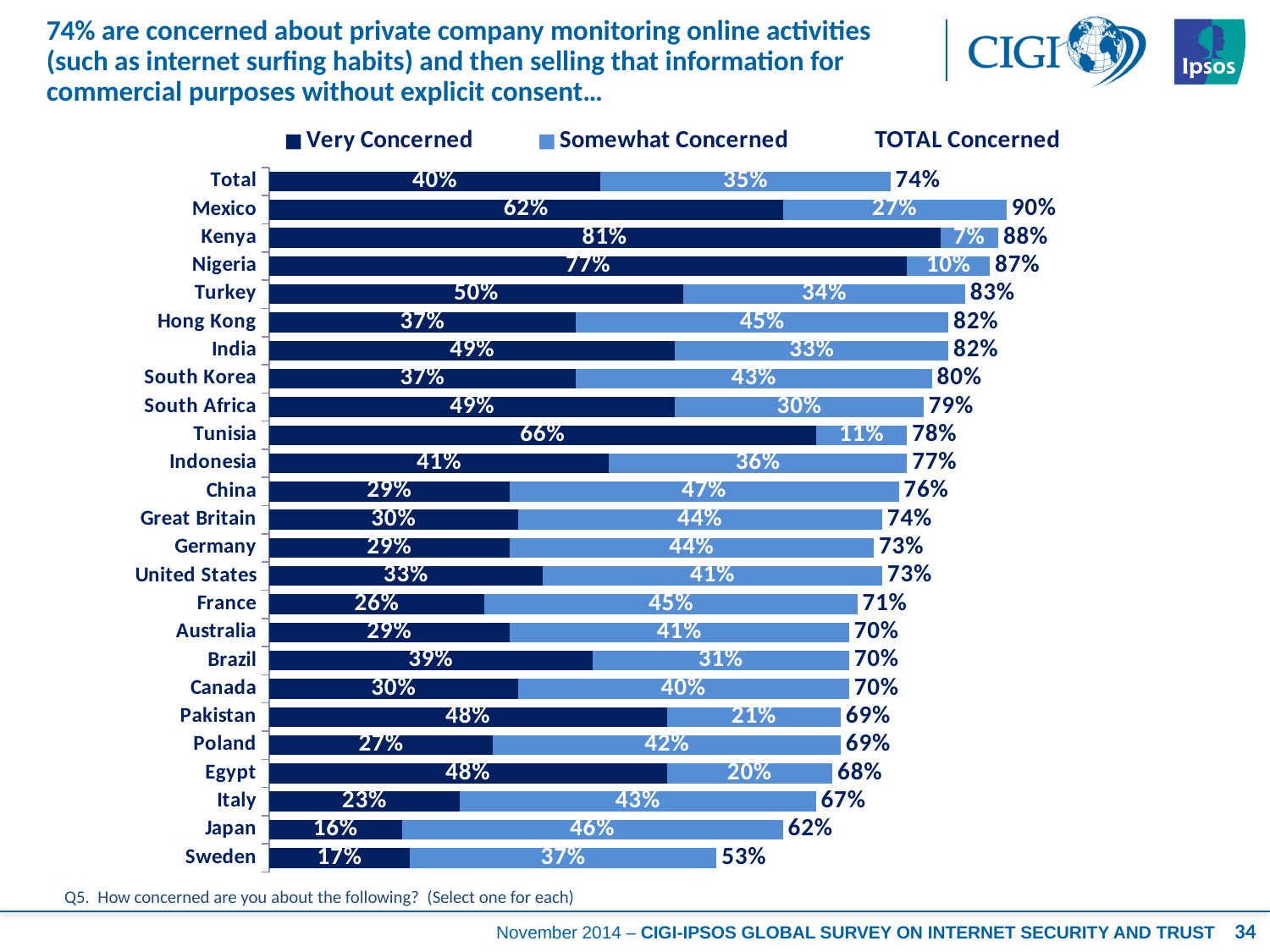
Which has a larger Somewhat Concerned value, China or Hong Kong? China What percentage of respondents in Kenya are Very Concerned? 81% What is the Somewhat Concerned value for Japan? 46% What kind of chart is shown on the slide? Stacked bar chart What is the TOTAL Concerned value for Mexico? 90% How many percentage points higher is Mexico's Very Concerned value than the Total's Very Concerned value? 22 percentage points How many series does the legend list with colour swatches? 2 What is the combined total of the Very Concerned and Somewhat Concerned segments for Kenya? 88% How many categories (rows) are shown in the chart? 25 Which country has the lowest Very Concerned percentage? Japan Which country has the lowest TOTAL Concerned percentage? Sweden Which country has the highest Very Concerned percentage? Kenya